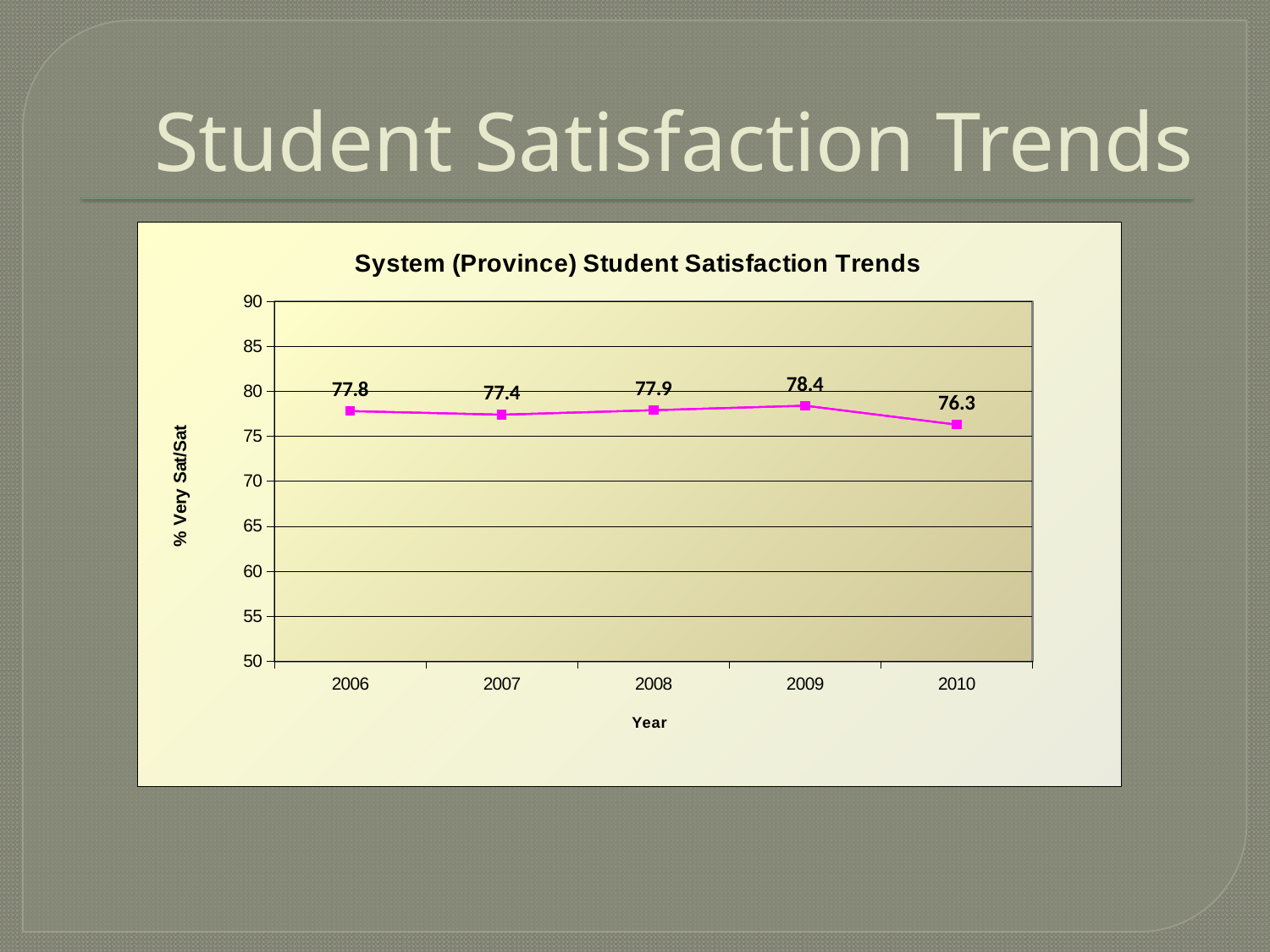
What is the difference between the values for 2009 and 2010? 2.1 How many years are plotted on the chart? 5 Which is larger, the value for 2007 or the value for 2008? 2008 What is the title of the chart? System (Province) Student Satisfaction Trends Is the value for 2010 greater or less than 80? less Does the value rise or fall from 2009 to 2010? fall Which year has the lowest value? 2010 What is the value for 2009? 78.4 What is the value for 2006? 77.8 Which year has the highest value? 2009 What kind of chart is shown? line chart What is the value for 2010? 76.3